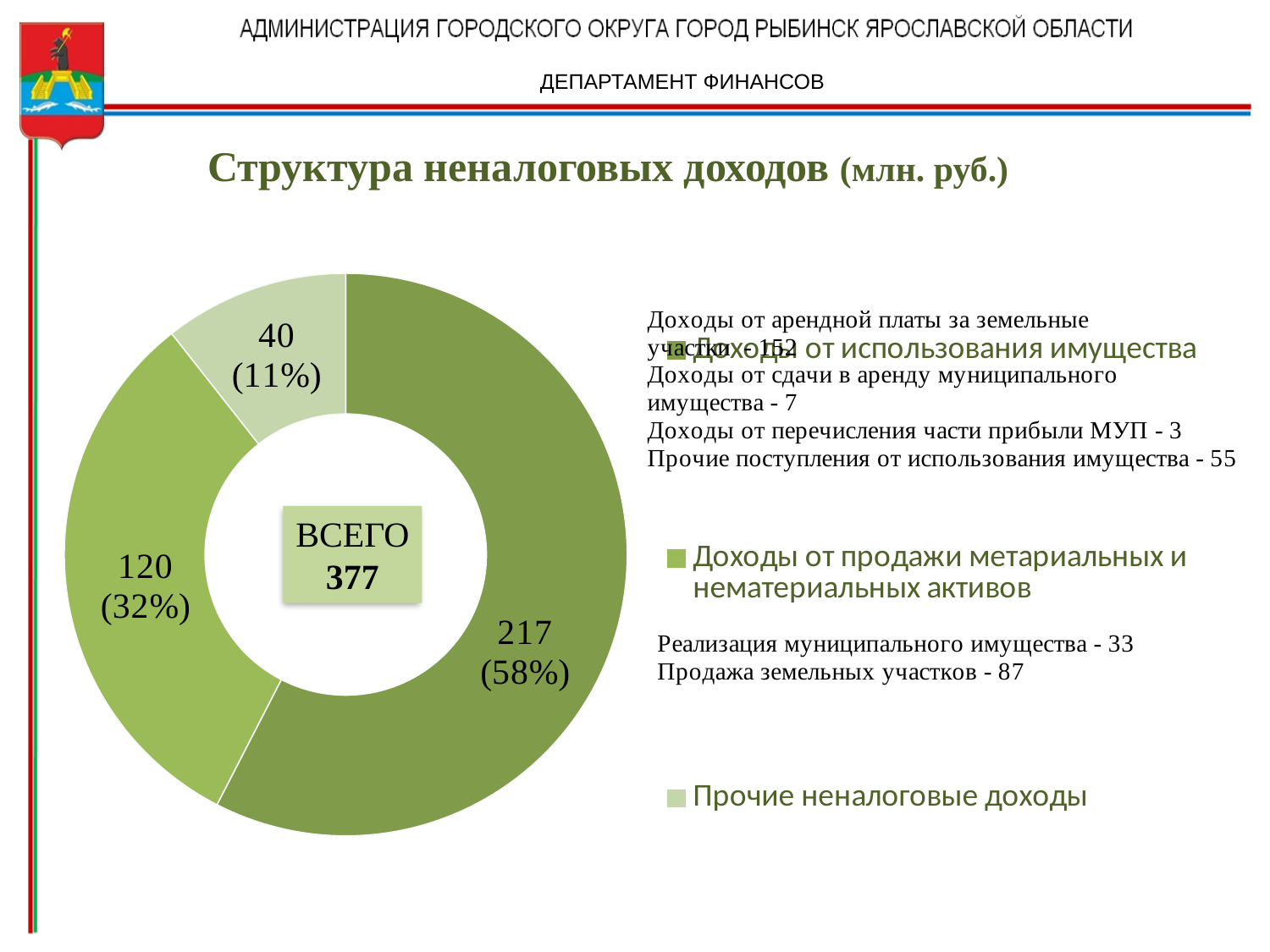
What share of the chart does "Прочие неналоговые доходы" take? 11% Which category has the smallest slice? Прочие неналоговые доходы What is the difference between the values for "Доходы от использования имущества" and "Доходы от продажи метариальных и нематериальных активов"? 97 What share of the chart does "Доходы от использования имущества" take? 58% What is the value for "Доходы от продажи метариальных и нематериальных активов"? 120 What is the value for "Прочие неналоговые доходы"? 40 Which category has the largest slice? Доходы от использования имущества What is the value for "Доходы от использования имущества"? 217 What kind of chart is shown on the slide? Doughnut (pie) chart Which is larger: "Доходы от продажи метариальных и нематериальных активов" or "Прочие неналоговые доходы"? Доходы от продажи метариальных и нематериальных активов How many slices does the chart have? 3 What total (ВСЕГО) is shown in the centre of the chart? 377